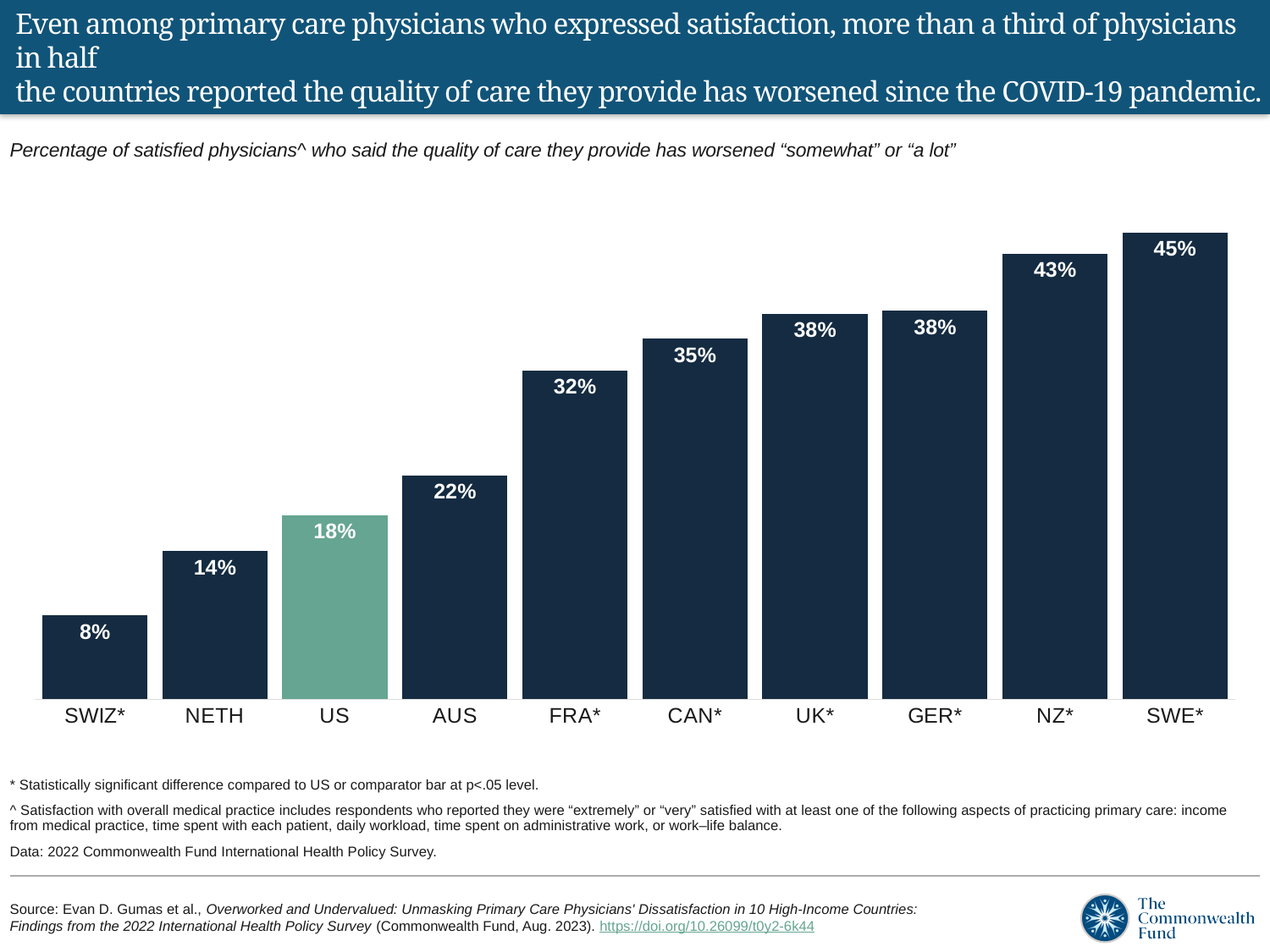
What kind of chart is shown on the slide? Bar chart What is the difference between the values for SWE* and SWIZ*? 37 percentage points How many countries are shown in the chart? 10 Do the values rise or fall from left to right along the x axis? Rise What is the value for NZ*? 43% Which bar is shown in a different colour (green) from the others? US Which is larger, the value for CAN* or the value for NETH? CAN* Which country has the highest value? SWE* What percentage is shown for FRA*? 32% What is the difference between the values for AUS and US? 4 percentage points What is the value for the US? 18% Which country has the lowest value? SWIZ*